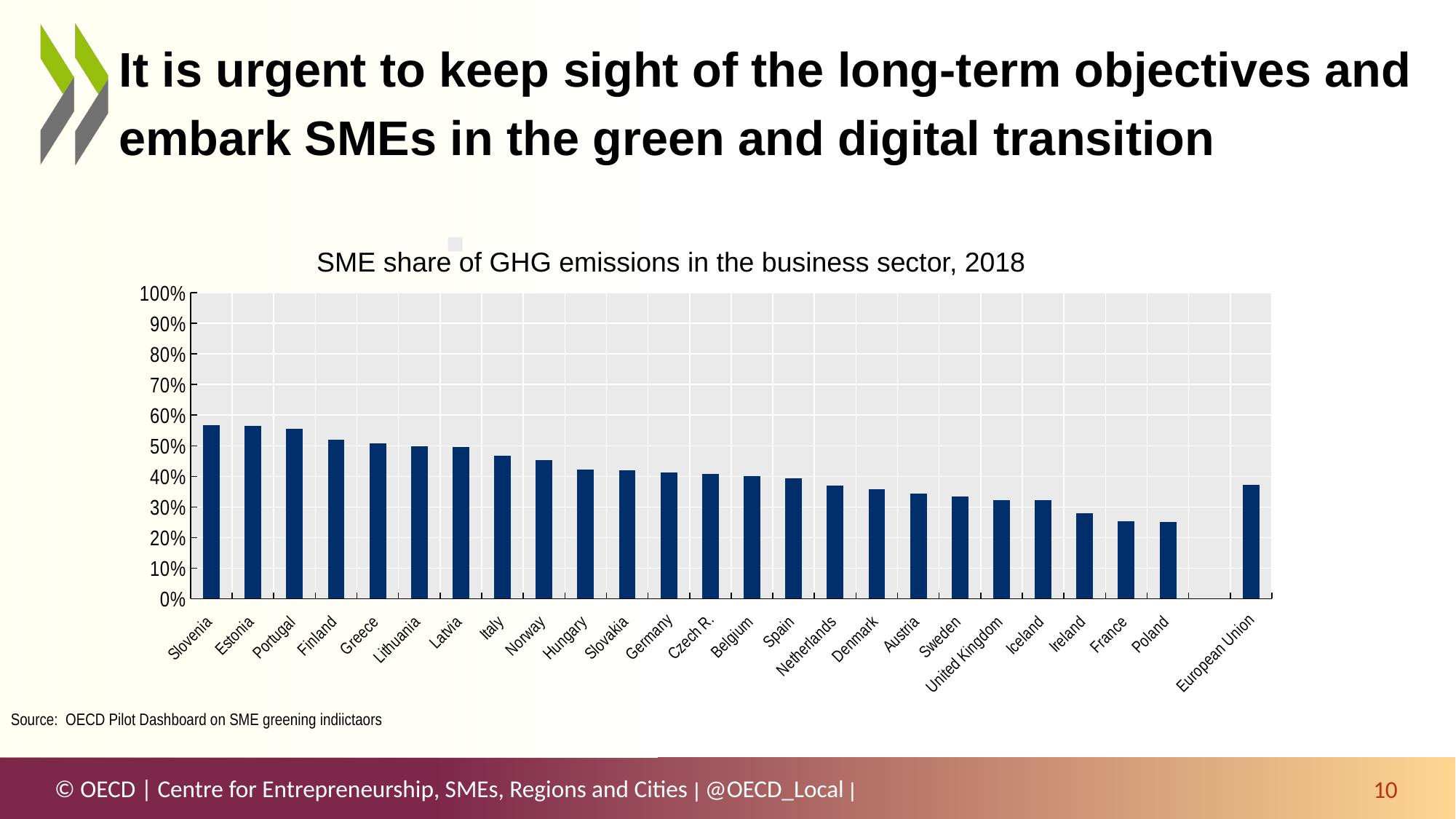
Which has a higher SME share of GHG emissions, Slovenia or Poland? Slovenia Which has a lower SME share of GHG emissions, Germany or Ireland? Ireland Do the bar values generally rise or fall moving from Slovenia on the left to Poland on the right? fall Is the value for Italy greater or less than 40%? greater Is the value for the European Union greater or less than 30%? greater Is the value for Slovenia greater or less than 50%? greater What is the title of the chart? SME share of GHG emissions in the business sector, 2018 How many bars (categories) are plotted in the chart? 25 Which has a higher SME share of GHG emissions, Sweden or Italy? Italy What kind of chart is shown on the slide? bar chart